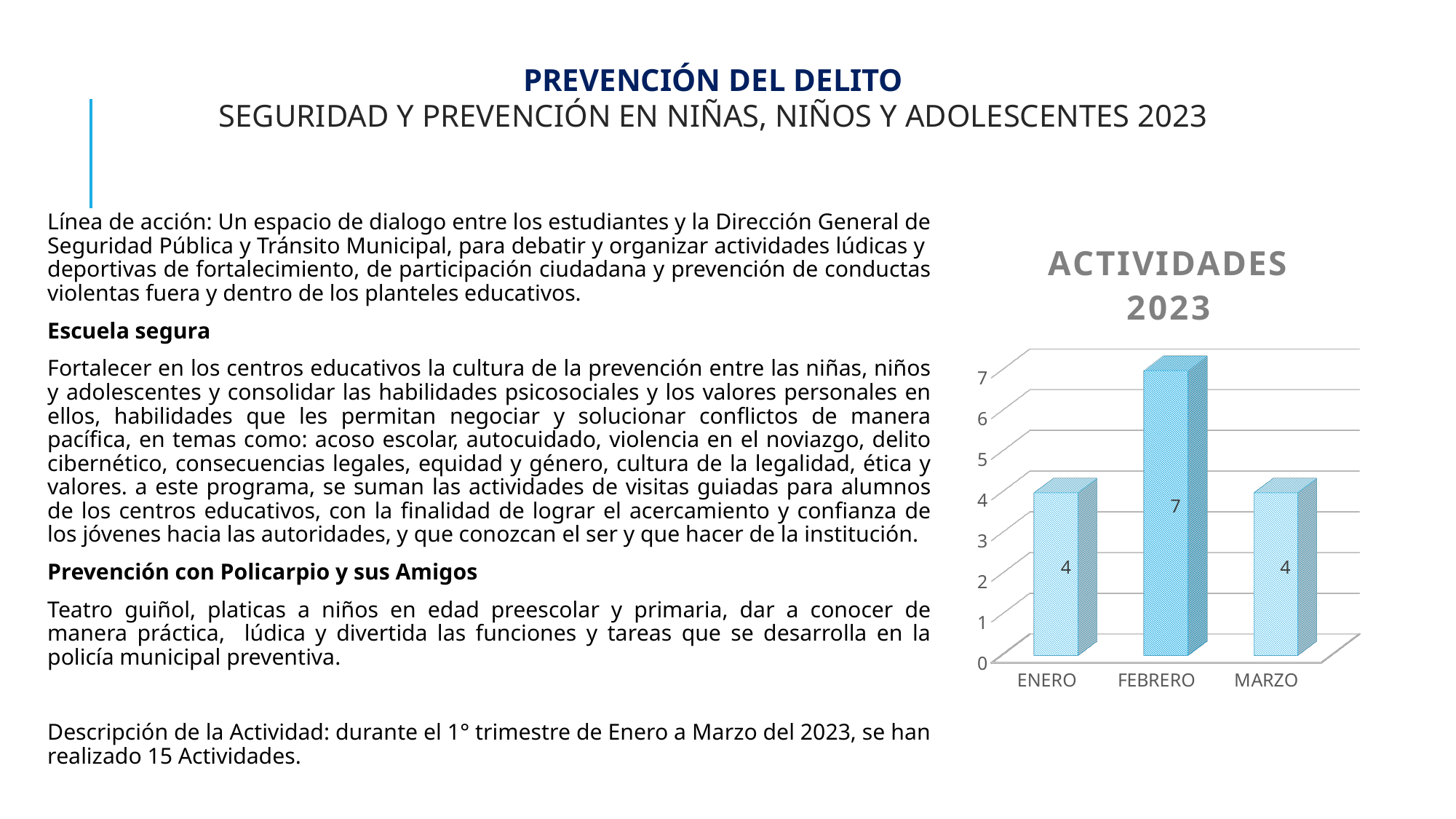
What is the highest value shown on the vertical axis of the ACTIVIDADES 2023 chart? 7 How many categories are shown in the ACTIVIDADES 2023 chart? 3 What is the difference between the values for FEBRERO and ENERO in the ACTIVIDADES 2023 chart? 3 What is the title of the chart on the slide? ACTIVIDADES 2023 What is the value for FEBRERO in the ACTIVIDADES 2023 chart? 7 Which month has the highest value in the ACTIVIDADES 2023 chart? FEBRERO Which is larger in the ACTIVIDADES 2023 chart, the value for FEBRERO or the value for MARZO? FEBRERO Is the value for FEBRERO in the ACTIVIDADES 2023 chart greater or less than 5? greater What is the total of the values for ENERO, FEBRERO and MARZO in the ACTIVIDADES 2023 chart? 15 What kind of chart is the ACTIVIDADES 2023 chart? bar chart What is the value for ENERO in the ACTIVIDADES 2023 chart? 4 What is the value for MARZO in the ACTIVIDADES 2023 chart? 4